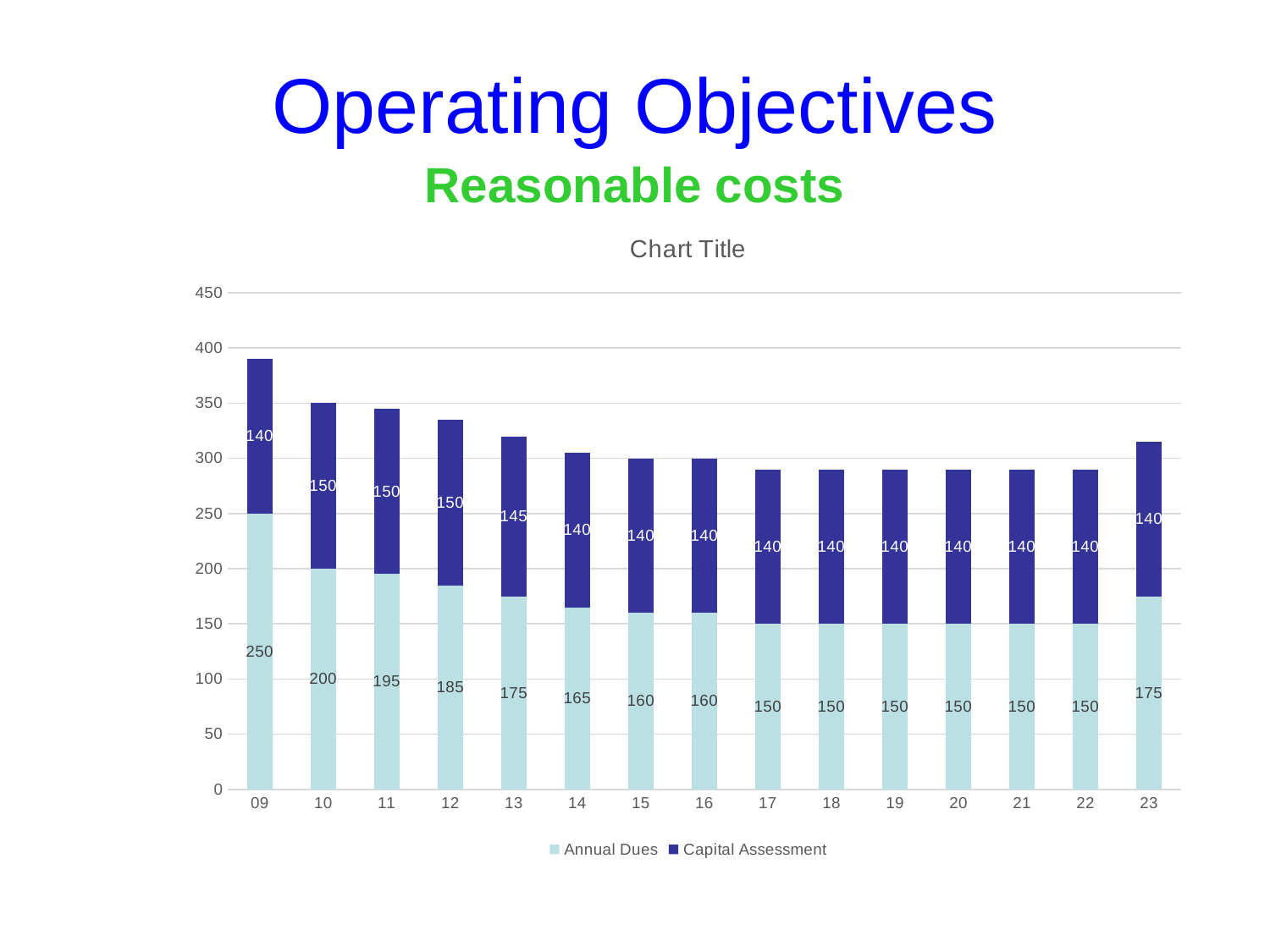
What is the total of the stacked bar for 09? 390 How many series does the legend list? 2 What is the Annual Dues value for 09? 250 What is the Capital Assessment value for 13? 145 What is the total of the stacked bar for 17? 290 Which is larger, the Capital Assessment value for 10 or for 14? 10 What type of chart is shown on the slide? stacked bar chart What is the Annual Dues value for 23? 175 How many categories (years) are shown on the x axis? 15 Which year has the highest Annual Dues value? 09 Do the Annual Dues values generally rise or fall from 09 to 22? fall What is the difference between the Annual Dues values for 09 and 10? 50